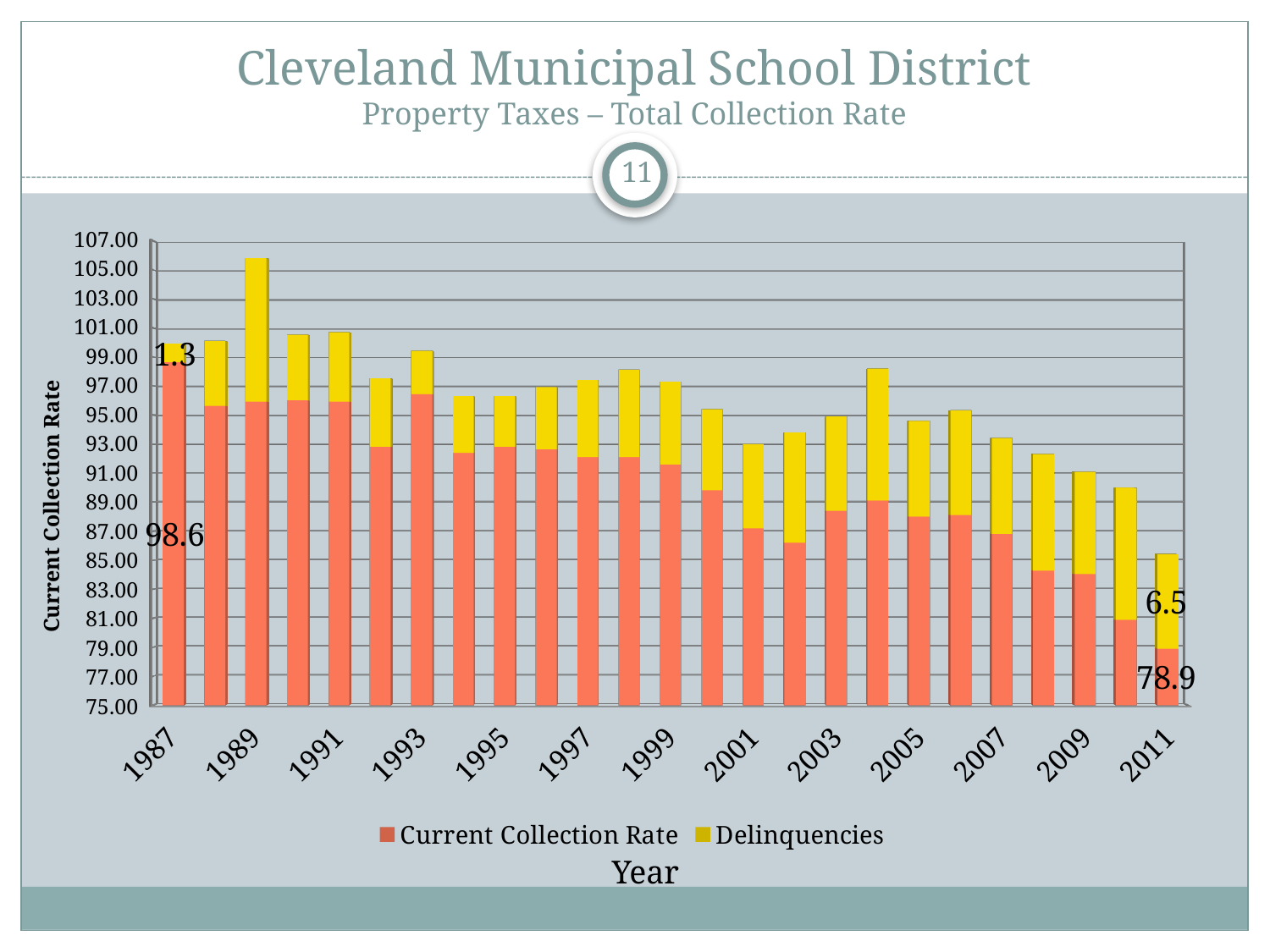
Which year has the higher Current Collection Rate, 1987 or 2011? 1987 What is the total height of the stacked bar for 2011 (Current Collection Rate plus Delinquencies)? 85.4 What is the Delinquencies value for 1987? 1.3 Is the Current Collection Rate for 2001 greater or less than 89.00? less Does the Current Collection Rate generally rise or fall from 1987 to 2011? fall What is the Current Collection Rate for 2011? 78.9 What is the Delinquencies value for 2011? 6.5 How many series does the legend list? 2 Which year has the tallest stacked bar overall? 1989 What is the difference between the Current Collection Rate in 1987 and in 2011? 19.7 Which year has the shortest stacked bar overall? 2011 What is the Current Collection Rate for 1987? 98.6